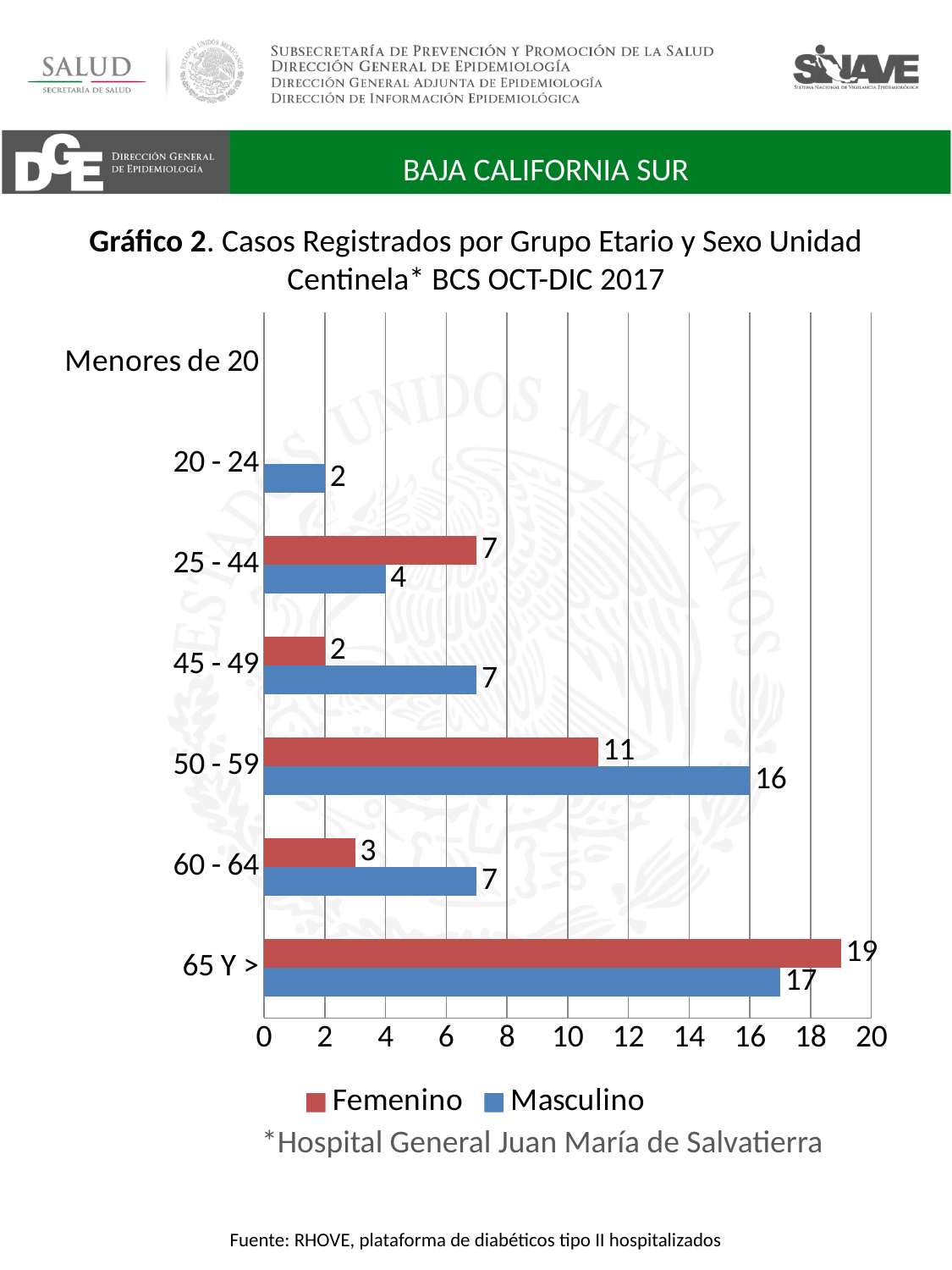
For the 25 - 44 age group, which is larger, Femenino or Masculino? Femenino Which age group has the highest Masculino value? 65 Y > Which age group has the highest Femenino value? 65 Y > How many age group categories are shown on the y axis? 7 What is the Femenino value for the 45 - 49 age group? 2 For the 60 - 64 age group, which is larger, Femenino or Masculino? Masculino What is the Masculino value for the 50 - 59 age group? 16 What is the Masculino value for the 20 - 24 age group? 2 What kind of chart is shown on the slide? Bar chart What is the difference between the Masculino and Femenino values for the 50 - 59 age group? 5 How many series does the legend list? 2 What is the Femenino value for the 65 Y > age group? 19